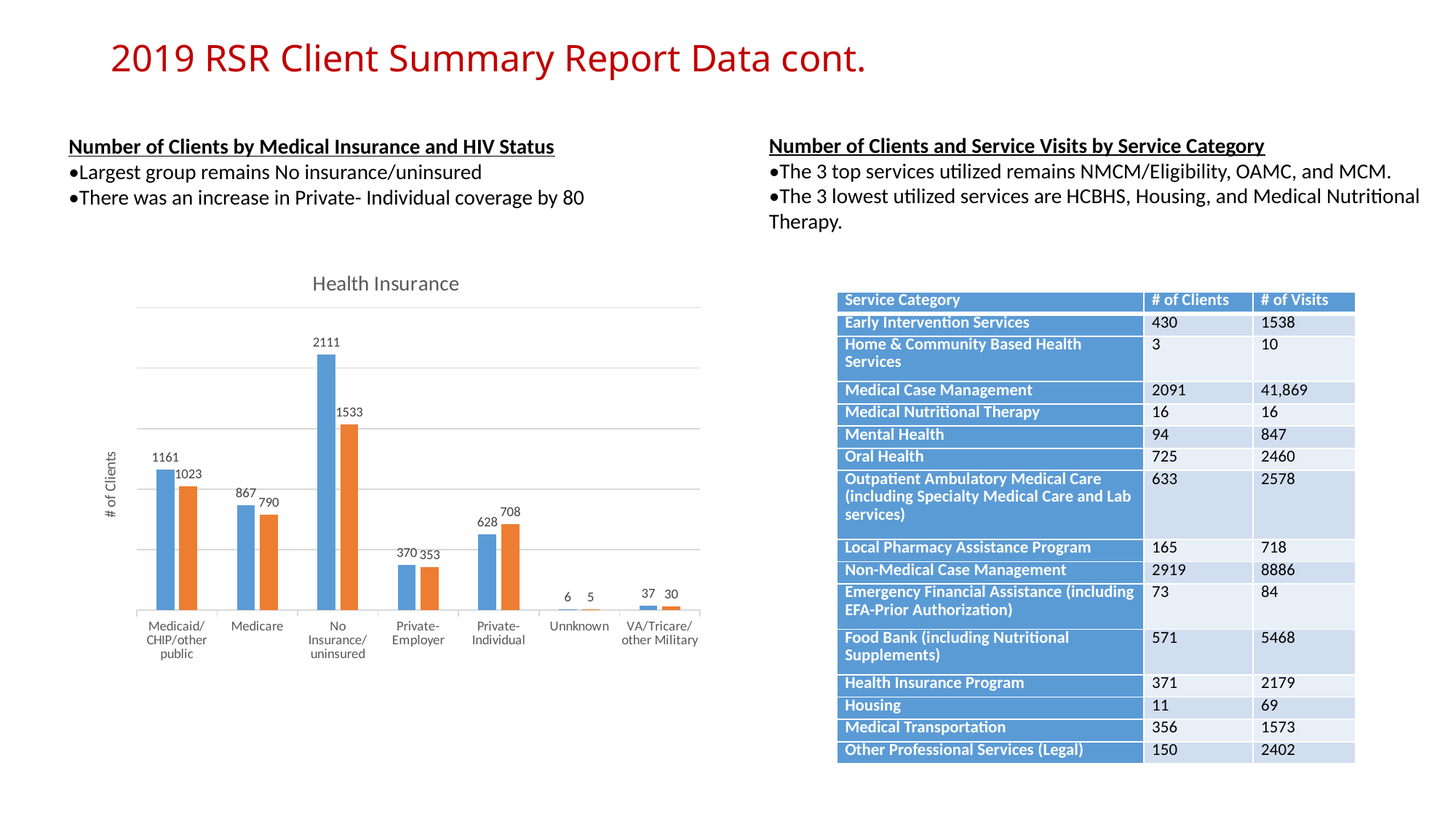
Which category has the lowest orange bar in the Health Insurance chart? Unnknown In the Health Insurance chart, what is the difference between the orange and blue bars for Private-Individual? 80 In the Health Insurance chart, what is the difference between the blue and orange bars for No Insurance/uninsured? 578 What is the value of the orange bar for Medicare in the Health Insurance chart? 790 What is the value of the blue bar for VA/Tricare/other Military in the Health Insurance chart? 37 How many categories are shown on the x axis of the Health Insurance chart? 7 In the Health Insurance chart, is the blue bar or the orange bar larger for Private-Individual? orange Which category has the highest blue bar in the Health Insurance chart? No Insurance/uninsured What is the label on the vertical axis of the Health Insurance chart? # of Clients What kind of chart is the Health Insurance chart? bar chart What is the value of the orange bar for Private-Individual in the Health Insurance chart? 708 What is the value of the blue bar for No Insurance/uninsured in the Health Insurance chart? 2111